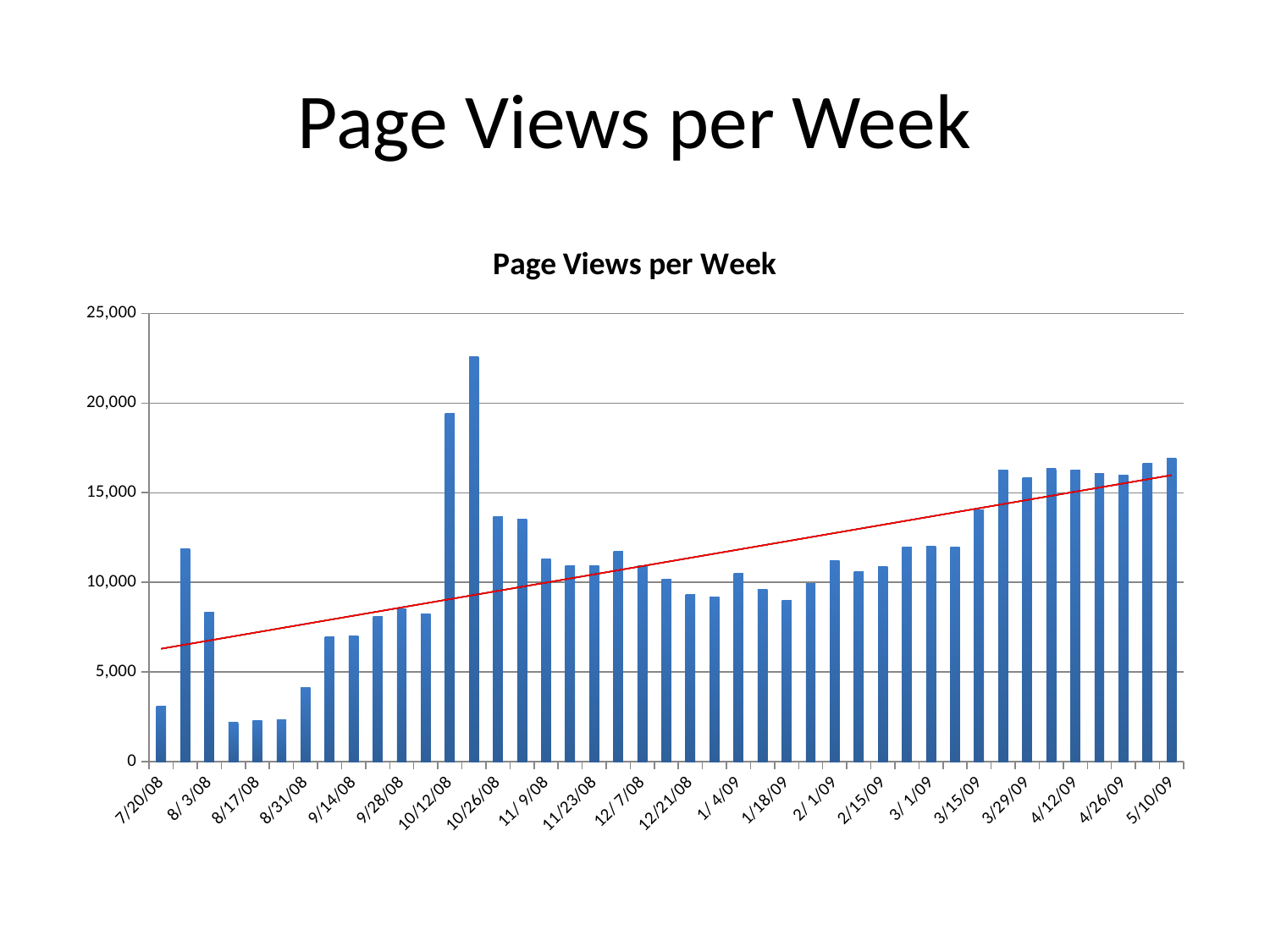
Does the red trend line rise or fall from left to right across the chart? rise Is the tallest bar in the chart greater or less than 20,000? greater What kind of chart is shown on the slide? bar chart Is the value for 5/10/09 greater or less than 15,000? greater Is the value for 7/20/08 greater or less than 5,000? less What is the title of the chart? Page Views per Week Which has the larger value, 8/3/08 or 8/17/08? 8/3/08 What colour are the bars in the chart? blue